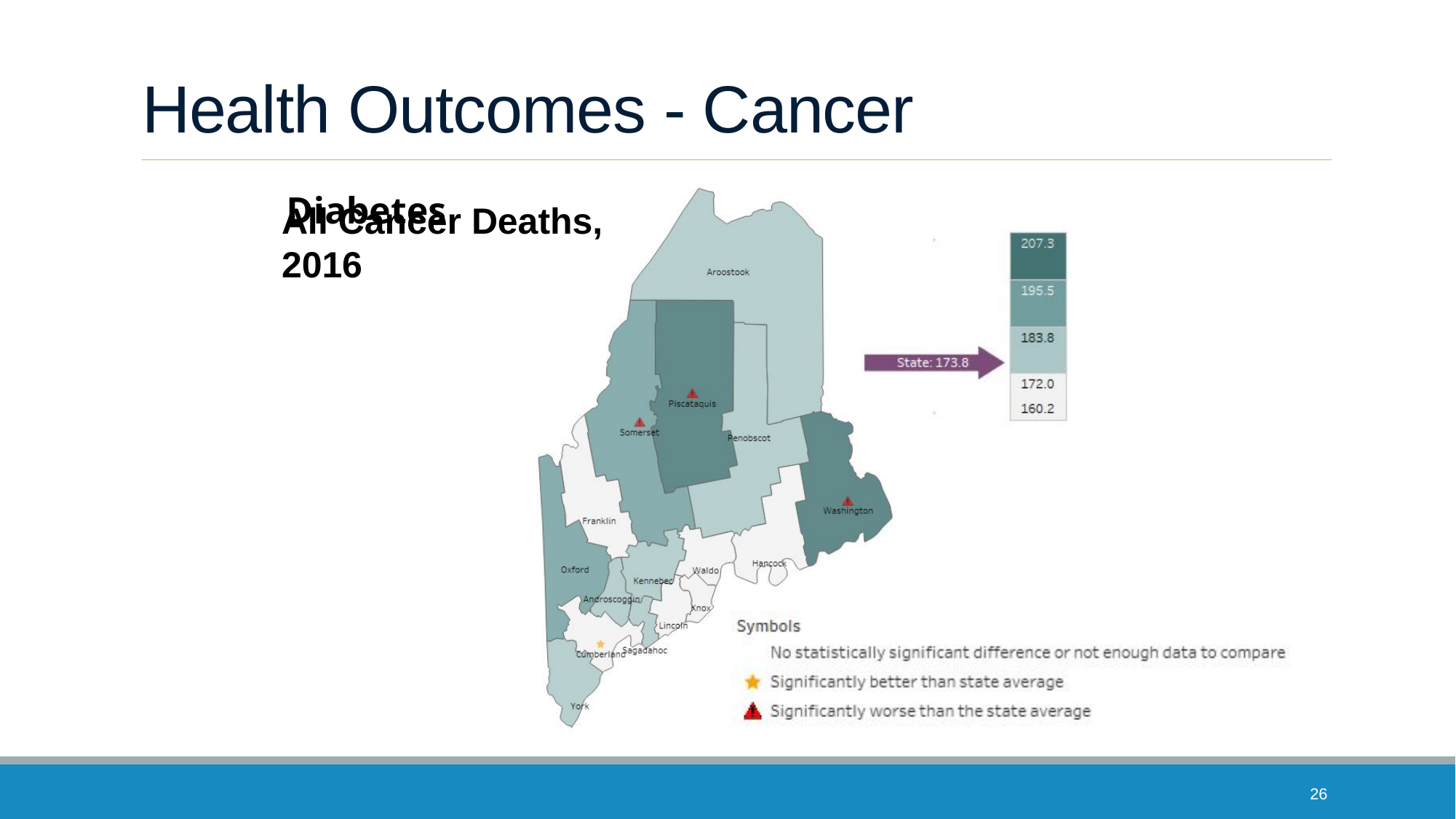
What is the state value shown on the map's legend arrow? 173.8 Which county on the map is marked with a star as significantly better than the state average? Cumberland Which counties on the map are marked as significantly worse than the state average? Piscataquis, Somerset, Washington What kind of chart is shown on the slide? A map (choropleth map of Maine counties) Which county is shaded darker on the map, Washington or Hancock? Washington How many entries does the map's Symbols key list? 3 How many counties on the map are marked with a red triangle (significantly worse than the state average)? 3 What symbol does the map's symbol key use for 'Significantly better than state average'? A yellow star Is the value for Washington county greater or less than 183.8? greater What is the highest value shown on the map's colour scale? 207.3 What is the lowest value shown on the map's colour scale? 160.2